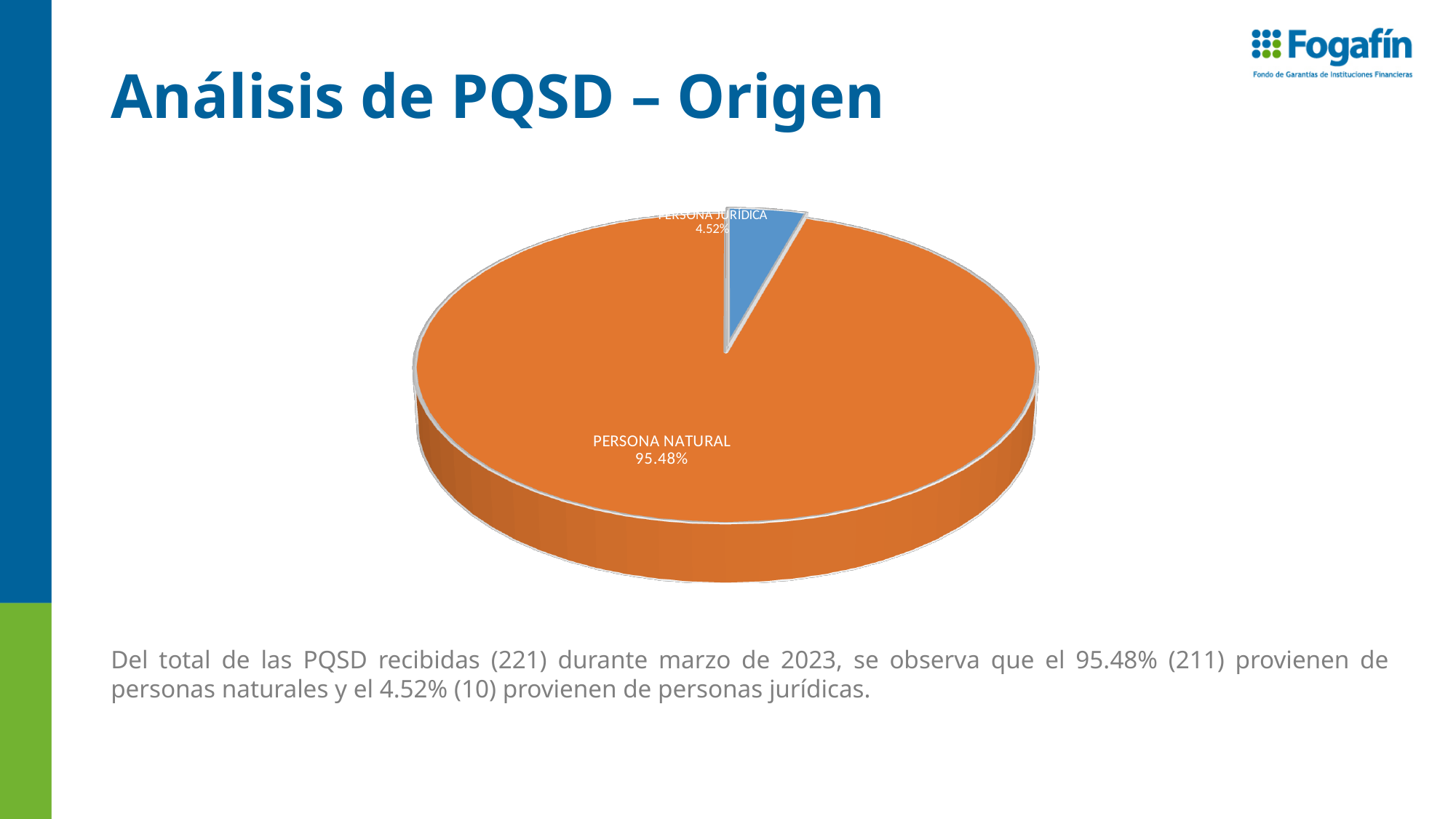
Is the share for PERSONA JURIDICA greater or less than 10%? less Which slice is larger, PERSONA NATURAL or PERSONA JURIDICA? PERSONA NATURAL What colour is the PERSONA JURIDICA slice? Blue Which category has the smallest slice of the pie? PERSONA JURIDICA What kind of chart is shown on the slide? Pie chart What share of the pie does PERSONA NATURAL represent? 95.48% How many slices does the pie chart have? 2 What colour is the PERSONA NATURAL slice? Orange Which category has the largest slice of the pie? PERSONA NATURAL What share of the pie does PERSONA JURIDICA represent? 4.52% What is the difference in percentage points between the PERSONA NATURAL and PERSONA JURIDICA slices? 90.96%